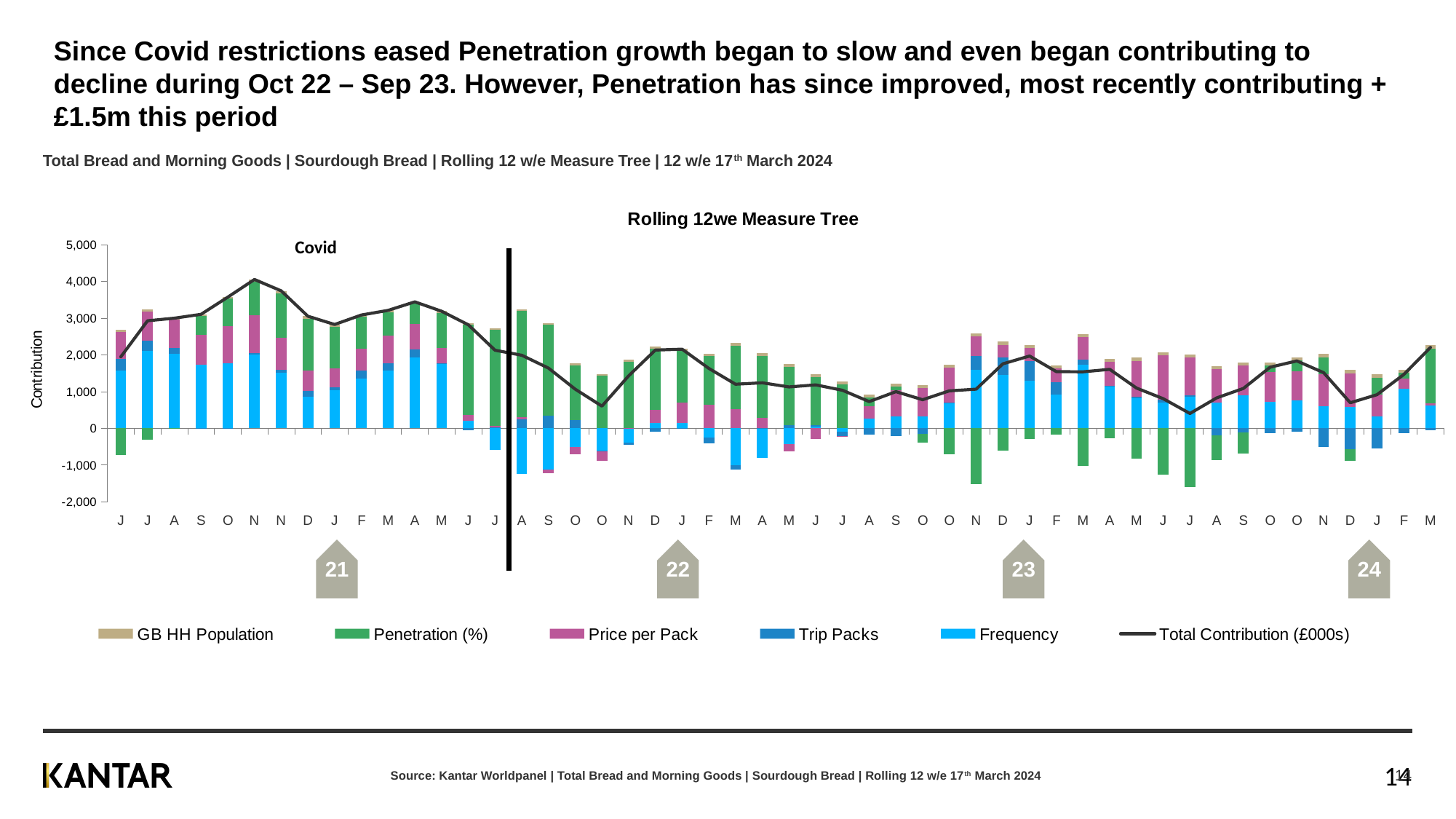
From the first month (J) to the peak at N near the 'Covid' label, does the Total Contribution (£000s) line rise or fall? rise Is the lowest point of the Total Contribution (£000s) line in 2023 (at J, between the '23' and '24' markers) greater or less than 1,000? less What is the label on the vertical axis of the chart? Contribution From the black vertical line to the following O, does the Total Contribution (£000s) line rise or fall? fall What is the title of the chart? Rolling 12we Measure Tree How many series does the legend list? 6 Is the highest point of the Total Contribution (£000s) line, near the 'Covid' label, greater or less than 3,000? greater Is the Total Contribution (£000s) value at the final month (M, 2024) greater or less than 1,000? greater Which is larger: the Total Contribution (£000s) at its peak near the 'Covid' label, or at the final month (M, 2024)? The peak near the 'Covid' label Which is larger: the Total Contribution (£000s) at the final month (M, 2024) or at the month before it (F)? M (2024) What kind of chart is shown on the slide? Stacked bar chart with a line